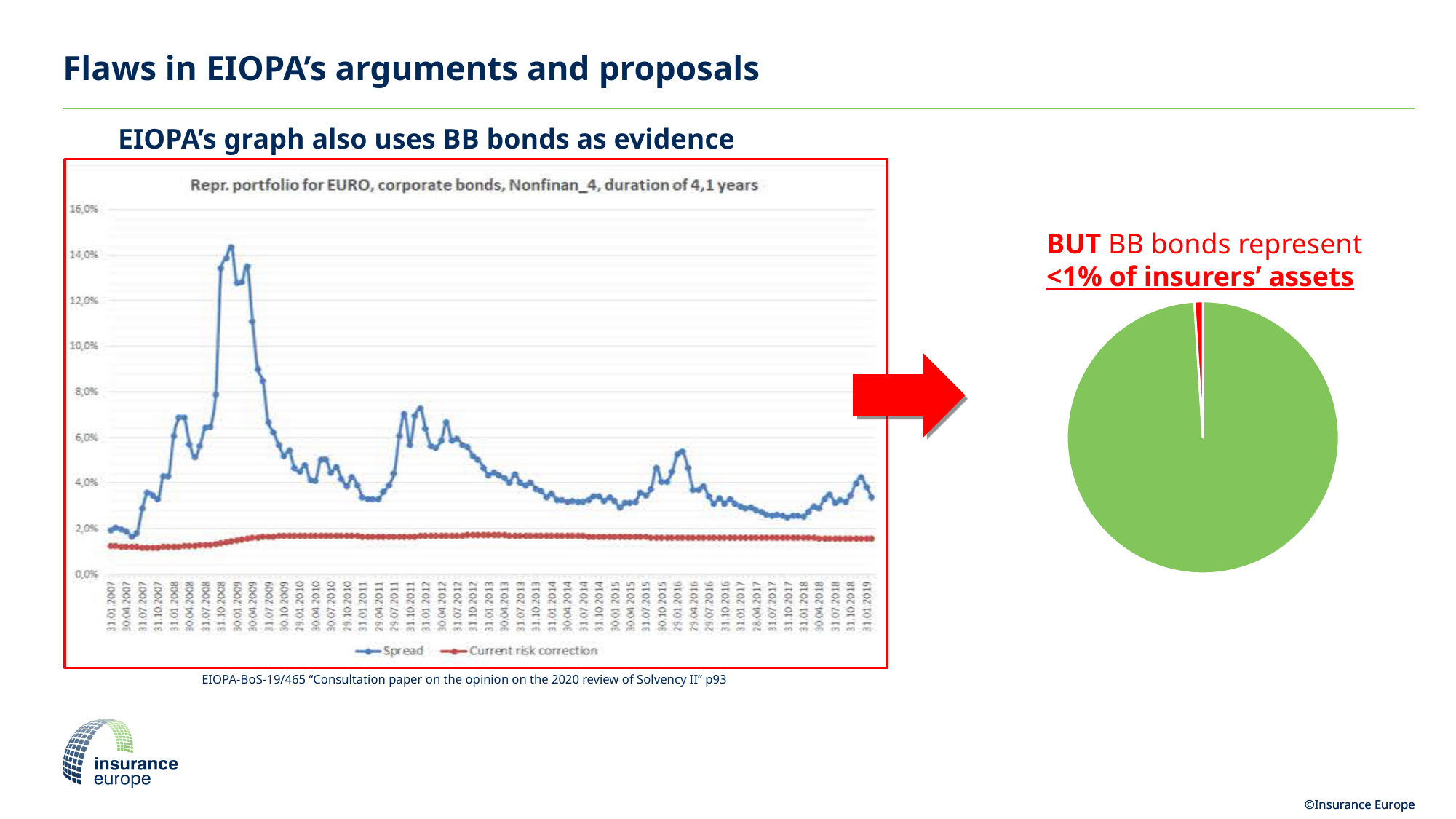
In the line chart on the left, which series is drawn in blue? Spread In the line chart on the left, what are the two series named in the legend? Spread and Current risk correction In the pie chart on the right, how many slices are there? 2 According to the slide, what share of insurers' assets do BB bonds represent in the pie chart on the right? <1% In the line chart on the left, is the Current risk correction series ever greater than 2,0%, or does it stay less than 2,0% throughout? less What kind of chart is shown on the right of the slide, under the text "BUT BB bonds represent <1% of insurers' assets"? pie chart In the line chart on the left, is the Spread value at 31.01.2019 greater or less than 2,0%? greater In the line chart on the left, how many series does the legend list? 2 In the line chart on the left, is the peak value of the Spread series greater or less than 12,0%? greater What kind of chart is the chart on the left of the slide, titled "Repr. portfolio for EURO, corporate bonds, Nonfinan_4, duration of 4,1 years"? line chart In the line chart on the left, which series has the higher values across the period, Spread or Current risk correction? Spread In the line chart on the left, does the Spread series rise or fall between 31.01.2009 and 31.07.2009? fall